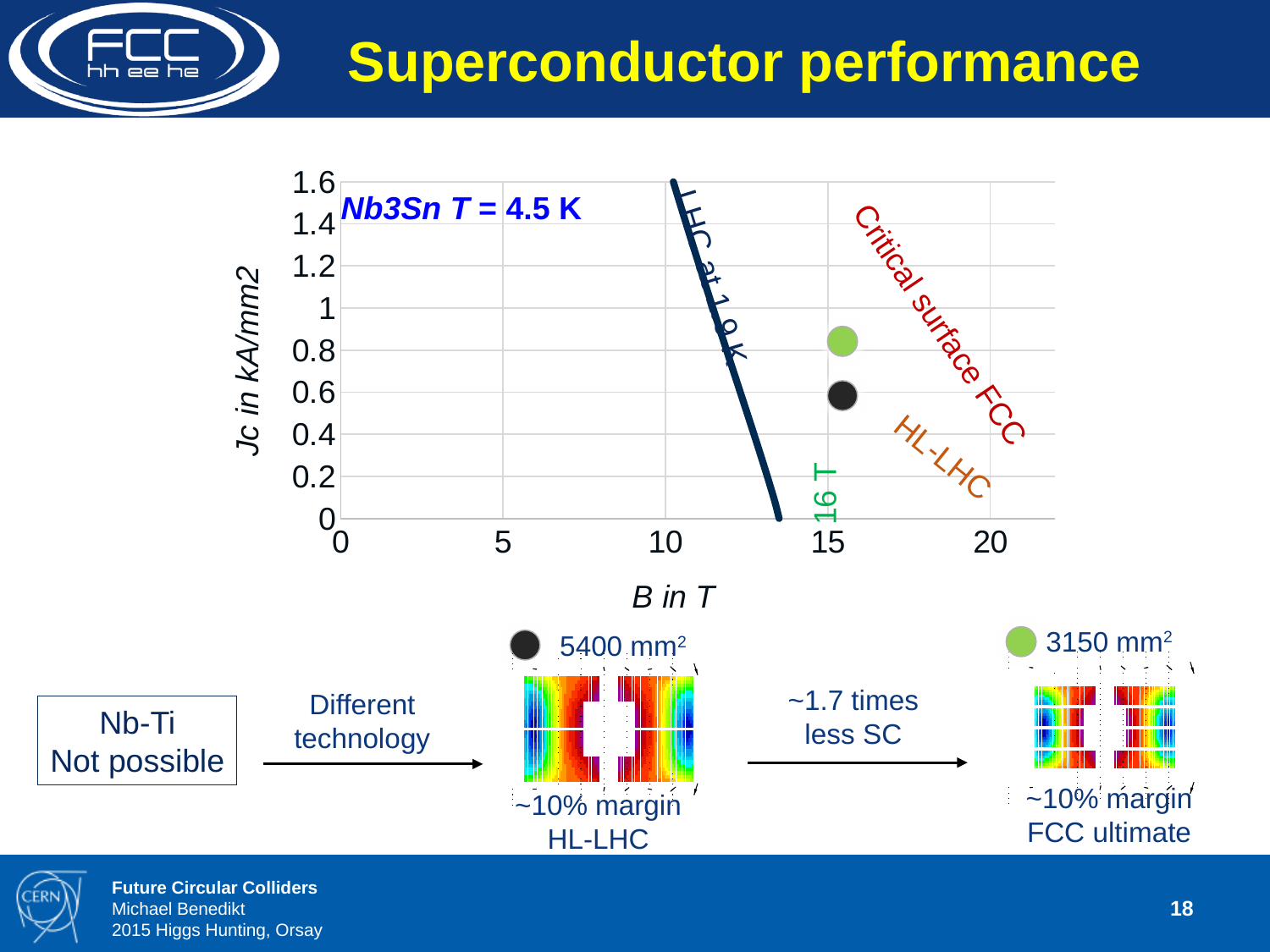
How many individual data points (circles) are plotted on the chart? 2 What is the label of the x axis of the chart? B in T Which of the two plotted points has the higher Jc value, the green point (FCC) or the black point (HL-LHC)? the green point (FCC) Is the B value of the black point (HL-LHC) greater or less than 20 T? less Is the Jc value of the black point (HL-LHC) greater or less than 0.4 kA/mm2? greater Does the 'LHC at 1.9 K' line rise or fall as B increases? fall Is the Jc value of the black point (HL-LHC) greater or less than 0.8 kA/mm2? less What is the label of the y axis of the chart? Jc in kA/mm2 What is the highest value shown on the y axis of the chart? 1.6